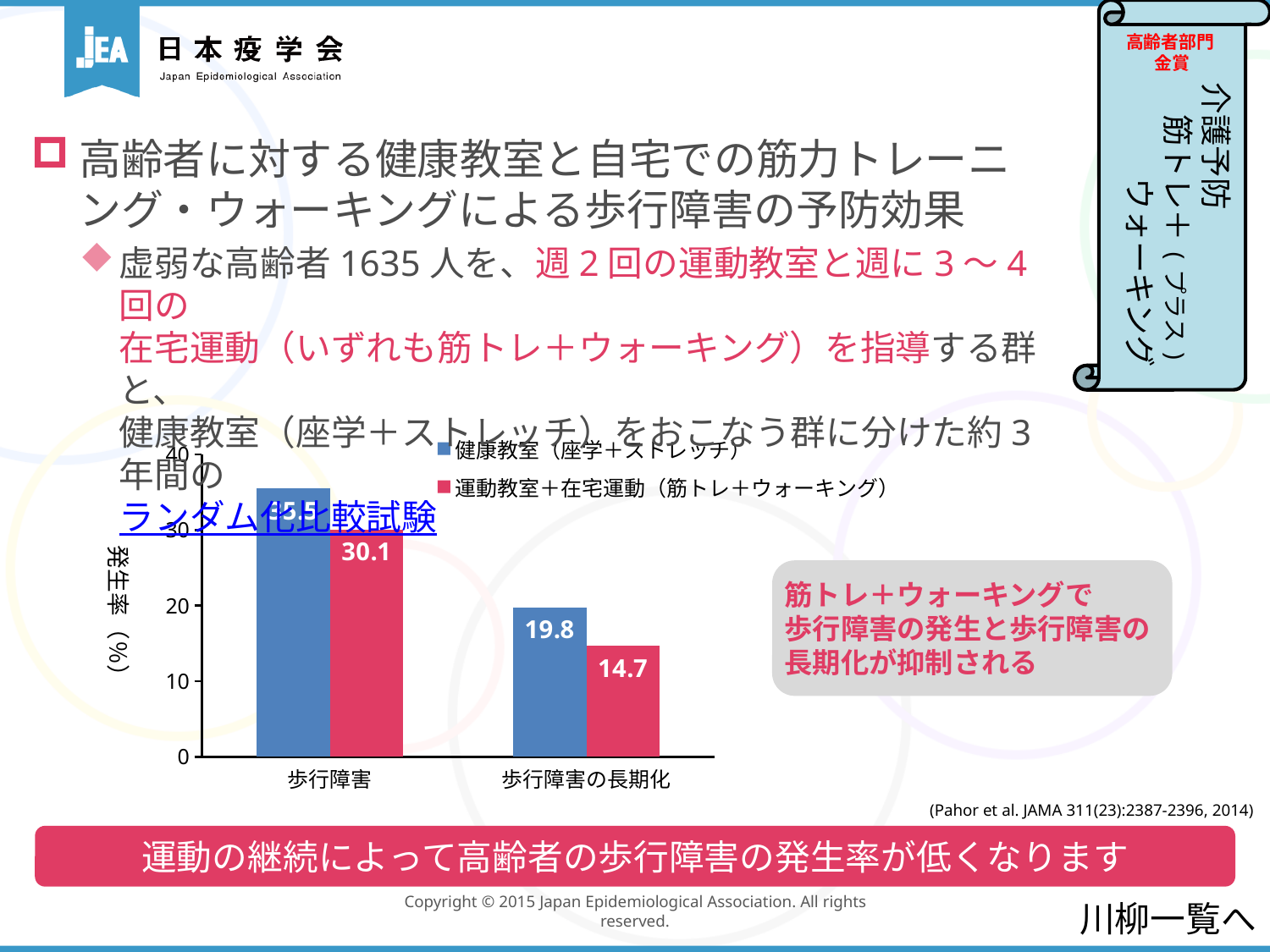
What kind of chart is shown on the slide? bar chart What is the value for 運動教室＋在宅運動（筋トレ＋ウォーキング） in the 歩行障害 category? 30.1 What is the label of the chart's y axis? 発生率（%） In the 歩行障害の長期化 category, what is the difference between the 健康教室（座学＋ストレッチ） value and the 運動教室＋在宅運動（筋トレ＋ウォーキング） value? 5.1 How many series does the chart's legend list? 2 What is the value for 健康教室（座学＋ストレッチ） in the 歩行障害の長期化 category? 19.8 In the 歩行障害 category, which series has the larger value: 健康教室（座学＋ストレッチ） or 運動教室＋在宅運動（筋トレ＋ウォーキング）? 健康教室（座学＋ストレッチ） Is the value for 健康教室（座学＋ストレッチ） in the 歩行障害 category greater or less than 30? greater Which bar in the chart is the highest? 健康教室（座学＋ストレッチ） in 歩行障害 Which bar in the chart is the lowest? 運動教室＋在宅運動（筋トレ＋ウォーキング） in 歩行障害の長期化 What is the value for 運動教室＋在宅運動（筋トレ＋ウォーキング） in the 歩行障害の長期化 category? 14.7 How many categories are shown on the x axis of the chart? 2